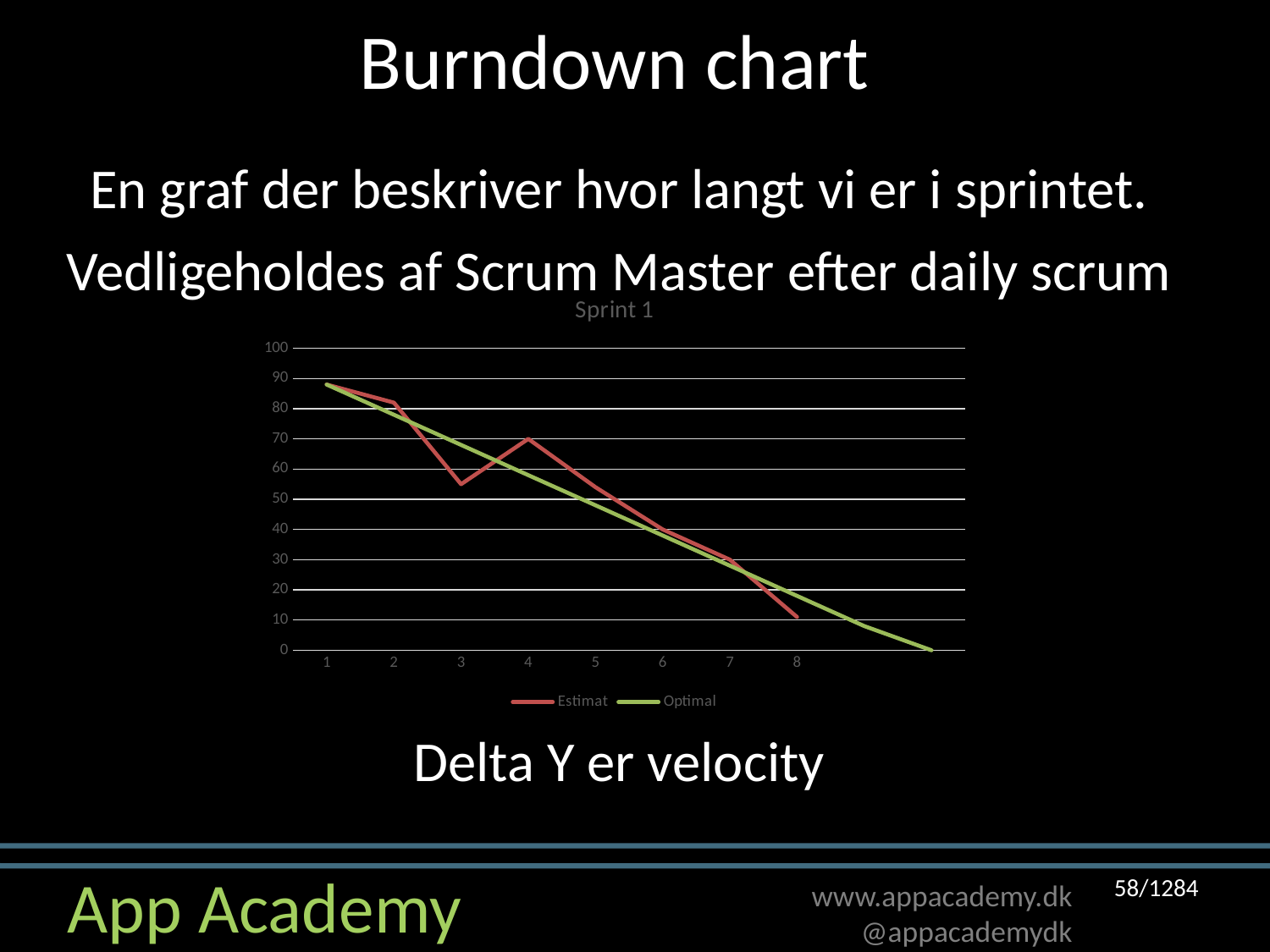
Is the Estimat value at x = 8 greater or less than 20? less Does the Optimal line rise or fall along the x axis? fall How many labeled points are there on the x axis? 8 How many series does the chart legend list? 2 Is the Estimat value at x = 3 greater or less than 60? less At which x-axis point is the Estimat series highest? 1 At x = 4, which series has the higher value, Estimat or Optimal? Estimat At x = 3, which series has the higher value, Estimat or Optimal? Optimal What are the two series named in the legend? Estimat and Optimal At which labeled x-axis point is the Estimat series lowest? 8 What is the title of the chart? Sprint 1 What kind of chart is shown on the slide? line chart